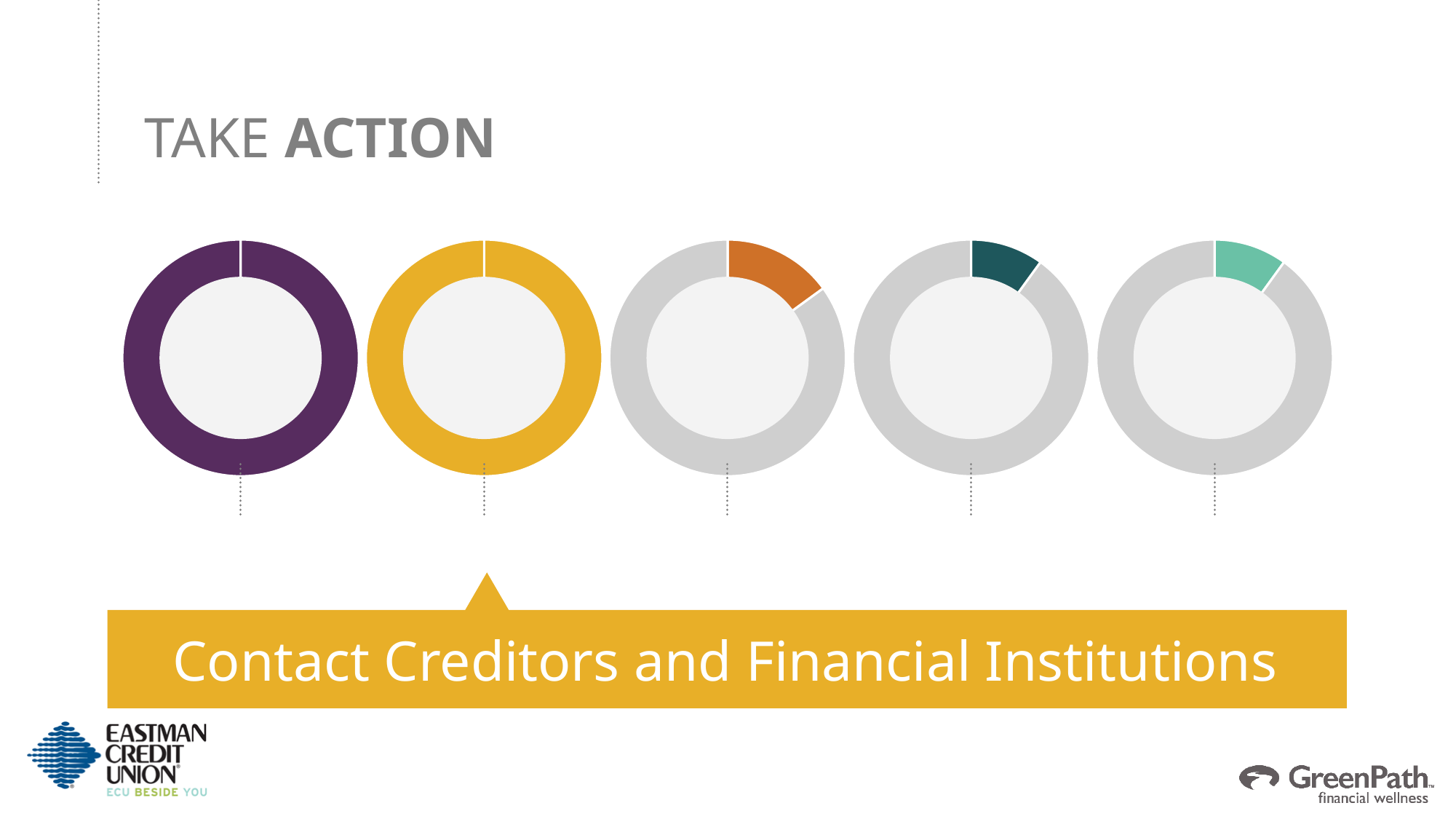
Is the filled portion of the third donut chart larger or smaller than the filled portion of the fourth donut chart? Larger What kind of charts are shown in the row across the middle of the slide? Donut charts How many donut charts are shown on the slide? 5 Is the filled portion of the second donut chart larger or smaller than the filled portion of the fifth (rightmost) donut chart? Larger Is the filled portion of the first (leftmost) donut chart larger or smaller than the filled portion of the third donut chart? Larger What colour is the ring of the first (leftmost) donut chart? Purple Which donut chart does the callout box reading "Contact Creditors and Financial Institutions" point to? The second donut chart